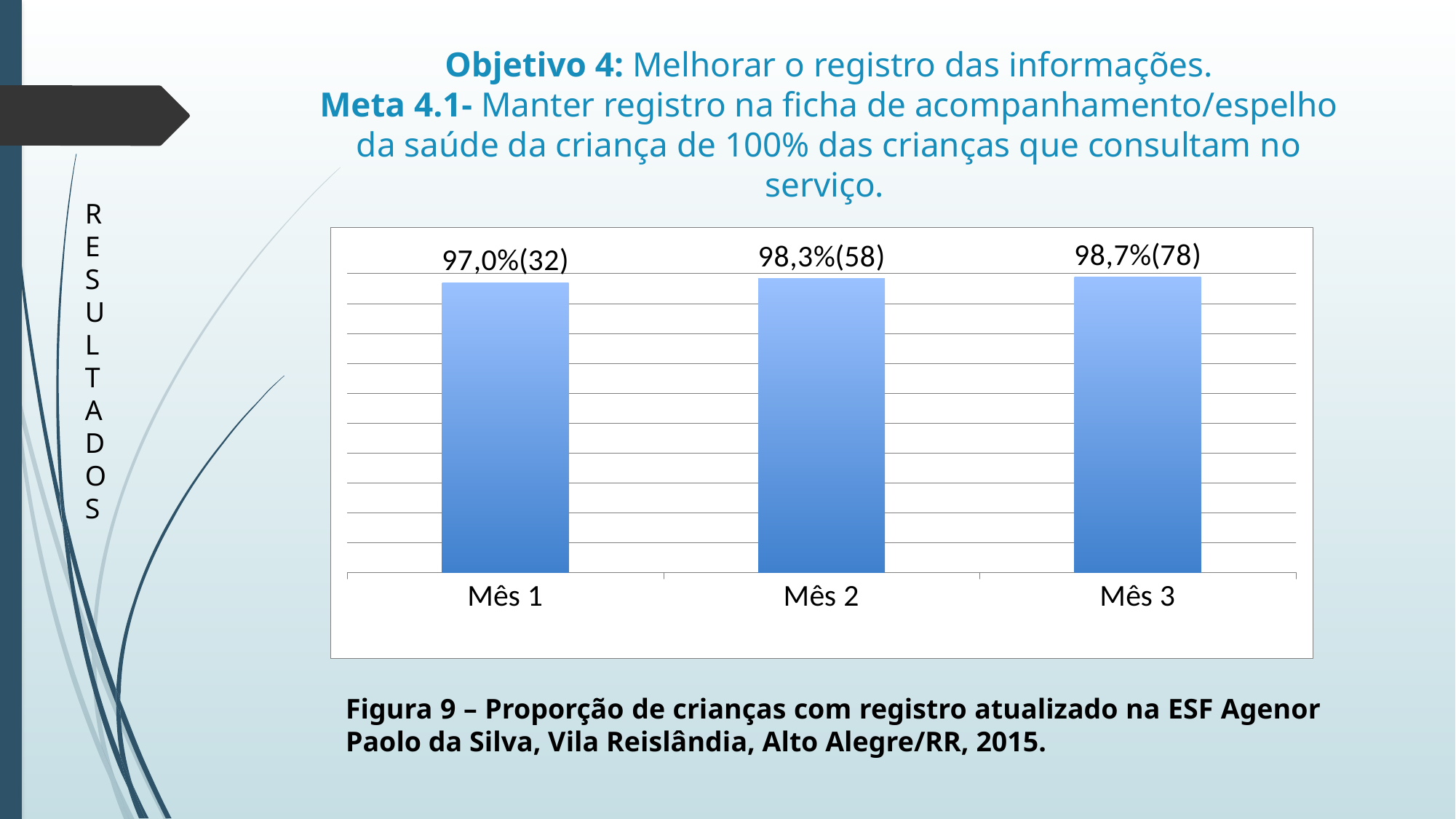
What is the difference in percentage points between Mês 3 and Mês 1? 1,7 Which month has the highest percentage? Mês 3 What percentage is shown for Mês 3? 98,7% Do the percentages rise or fall from Mês 1 to Mês 3? Rise What is the data label shown for Mês 2? 98,3%(58) What is the data label shown for Mês 1? 97,0%(32) Which month has the lowest percentage? Mês 1 How many months (categories) are shown on the x axis? 3 How many children are shown in parentheses for Mês 2? 58 What kind of chart is shown on the slide? Bar chart What is the difference between the number of children in parentheses for Mês 3 and Mês 1? 46 What is the data label shown for Mês 3? 98,7%(78)